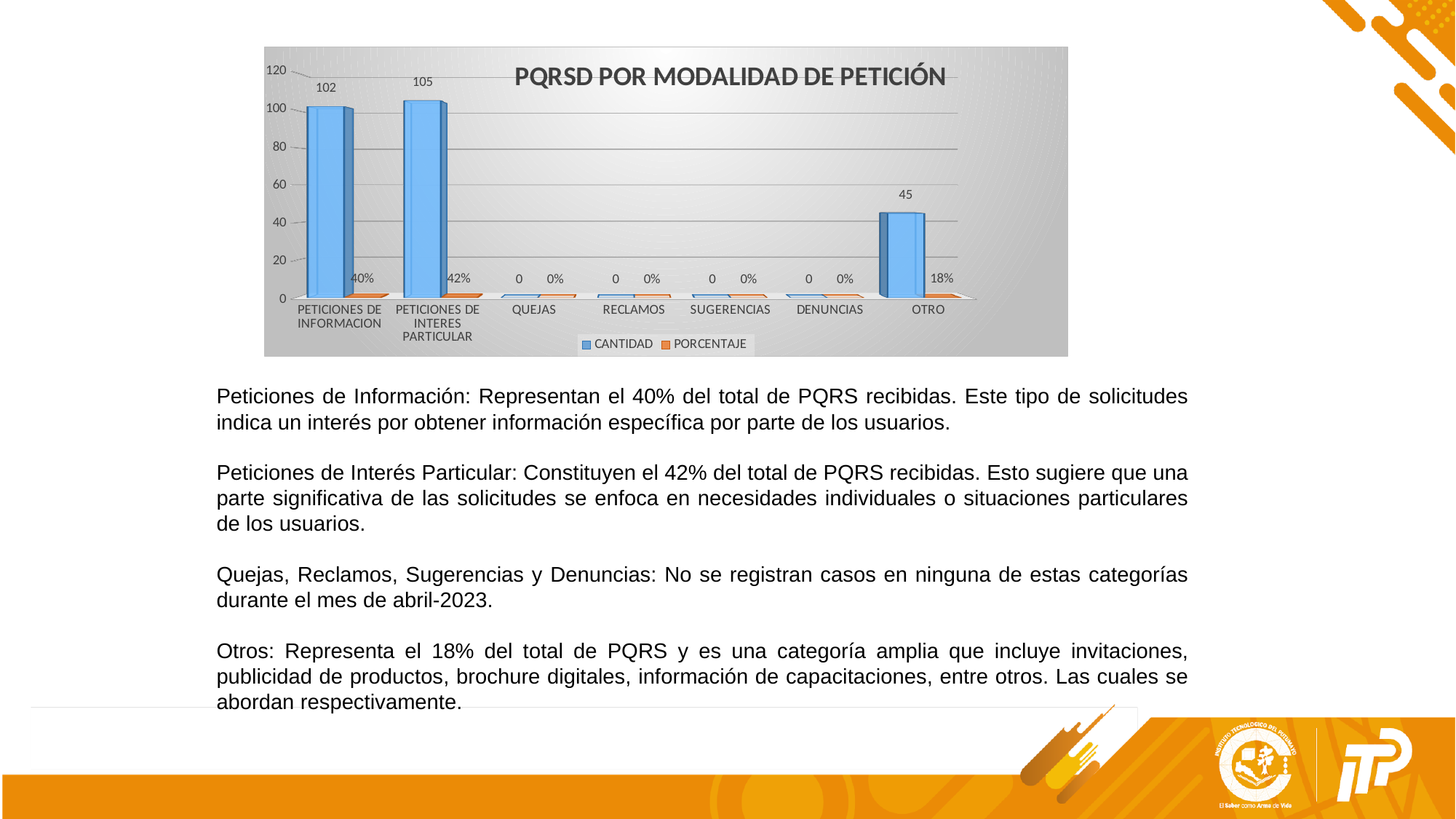
What is the CANTIDAD value for PETICIONES DE INFORMACION? 102 Which has a larger CANTIDAD value, PETICIONES DE INFORMACION or OTRO? PETICIONES DE INFORMACION What is the PORCENTAJE value for OTRO? 18% What is the CANTIDAD value for OTRO? 45 How many series does the legend list? 2 What is the PORCENTAJE value for PETICIONES DE INTERES PARTICULAR? 42% What is the title of the chart? PQRSD POR MODALIDAD DE PETICIÓN What is the difference in CANTIDAD between PETICIONES DE INFORMACION and OTRO? 57 What is the difference in CANTIDAD between PETICIONES DE INTERES PARTICULAR and PETICIONES DE INFORMACION? 3 Which category has the highest CANTIDAD value? PETICIONES DE INTERES PARTICULAR How many categories are shown on the x axis? 7 What is the CANTIDAD value for PETICIONES DE INTERES PARTICULAR? 105